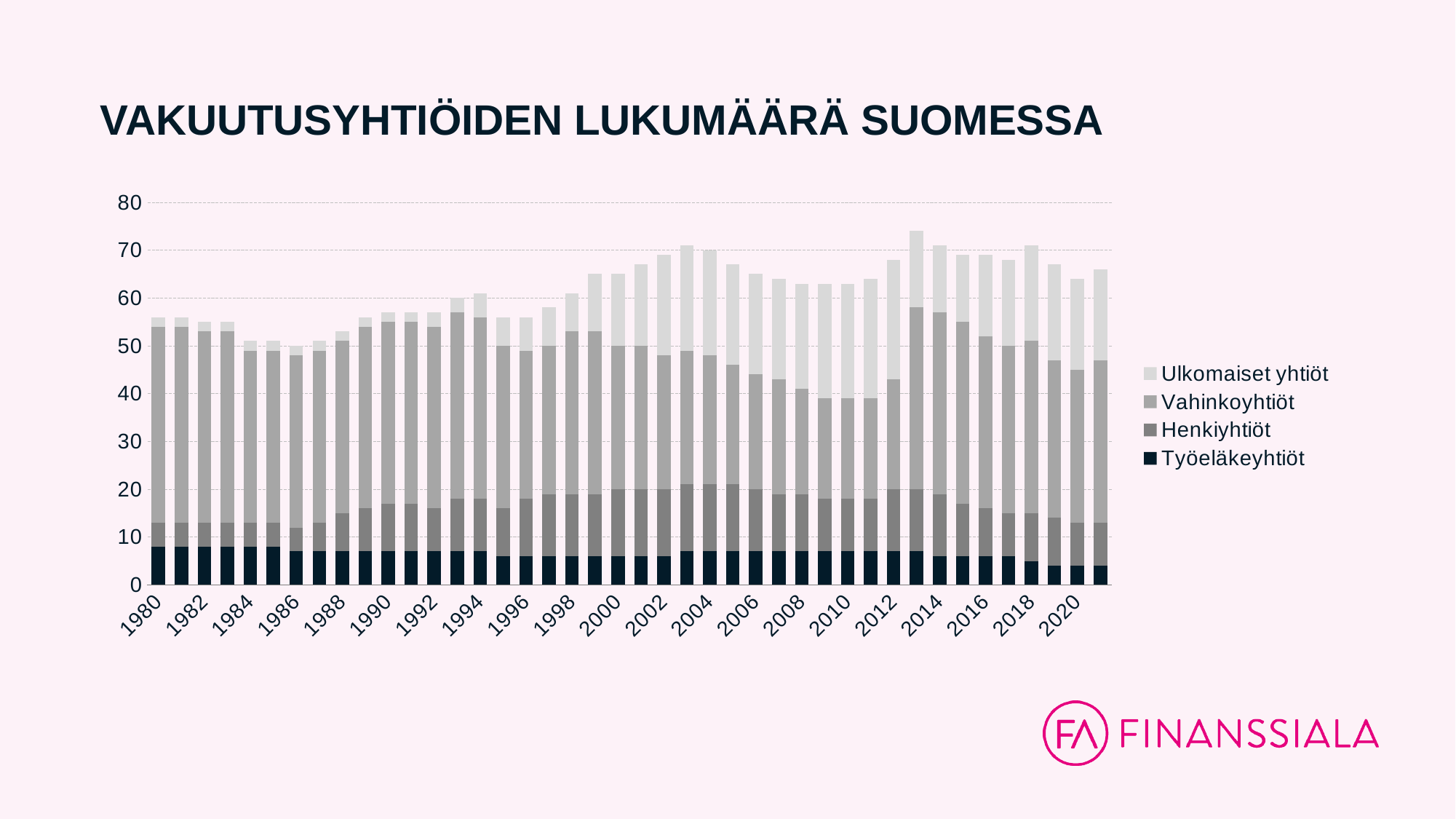
Do the total bar heights rise or fall from 1986 to 1994? rise Which series is listed last in the legend? Työeläkeyhtiöt How many series does the legend list? 4 What is the title of the chart? VAKUUTUSYHTIÖIDEN LUKUMÄÄRÄ SUOMESSA Is the total for 2010 greater or less than 60? greater Which year has the larger total, 1980 or 2000? 2000 Is the total for 1980 greater or less than 60? less Is the value for Työeläkeyhtiöt in 2021 greater or less than 10? less Which year has the highest total number of insurance companies? 2013 How many bars (years) are plotted in the chart? 42 What kind of chart is shown on the slide? Stacked bar chart